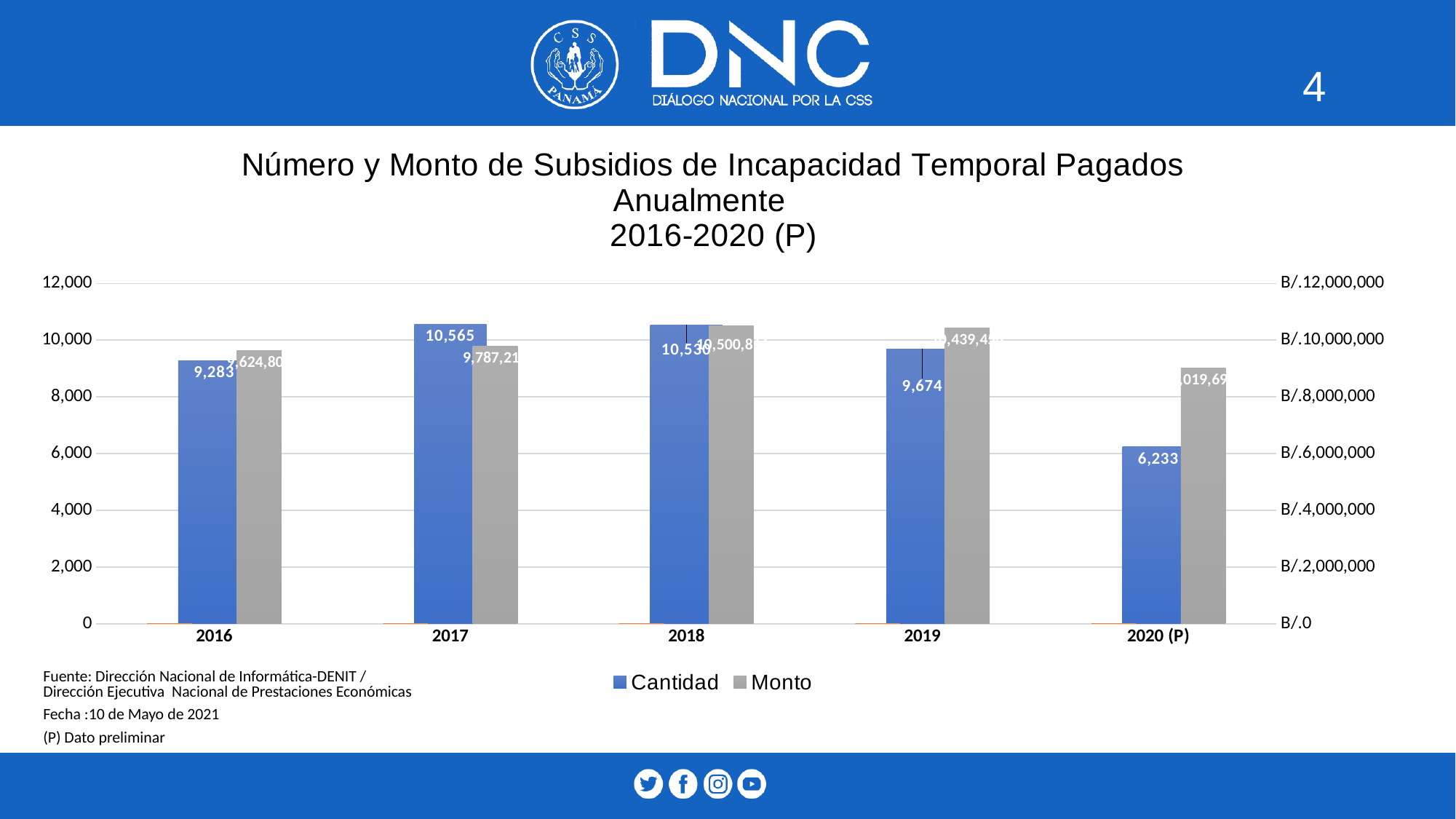
What kind of chart is shown on the slide? bar chart Which year has the highest Cantidad value? 2017 What is the Cantidad value for 2017? 10,565 Which year has the lowest Cantidad value? 2020 (P) How many years are shown on the x axis? 5 How many series does the legend list? 2 What is the difference between the Cantidad values for 2017 and 2020 (P)? 4,332 What is the Cantidad value for 2016? 9,283 Is the Monto value for 2020 (P) greater or less than B/.8,000,000? greater Which year has a larger Cantidad value, 2016 or 2019? 2019 What is the Cantidad value for 2020 (P)? 6,233 What is the difference between the Cantidad values for 2019 and 2016? 391